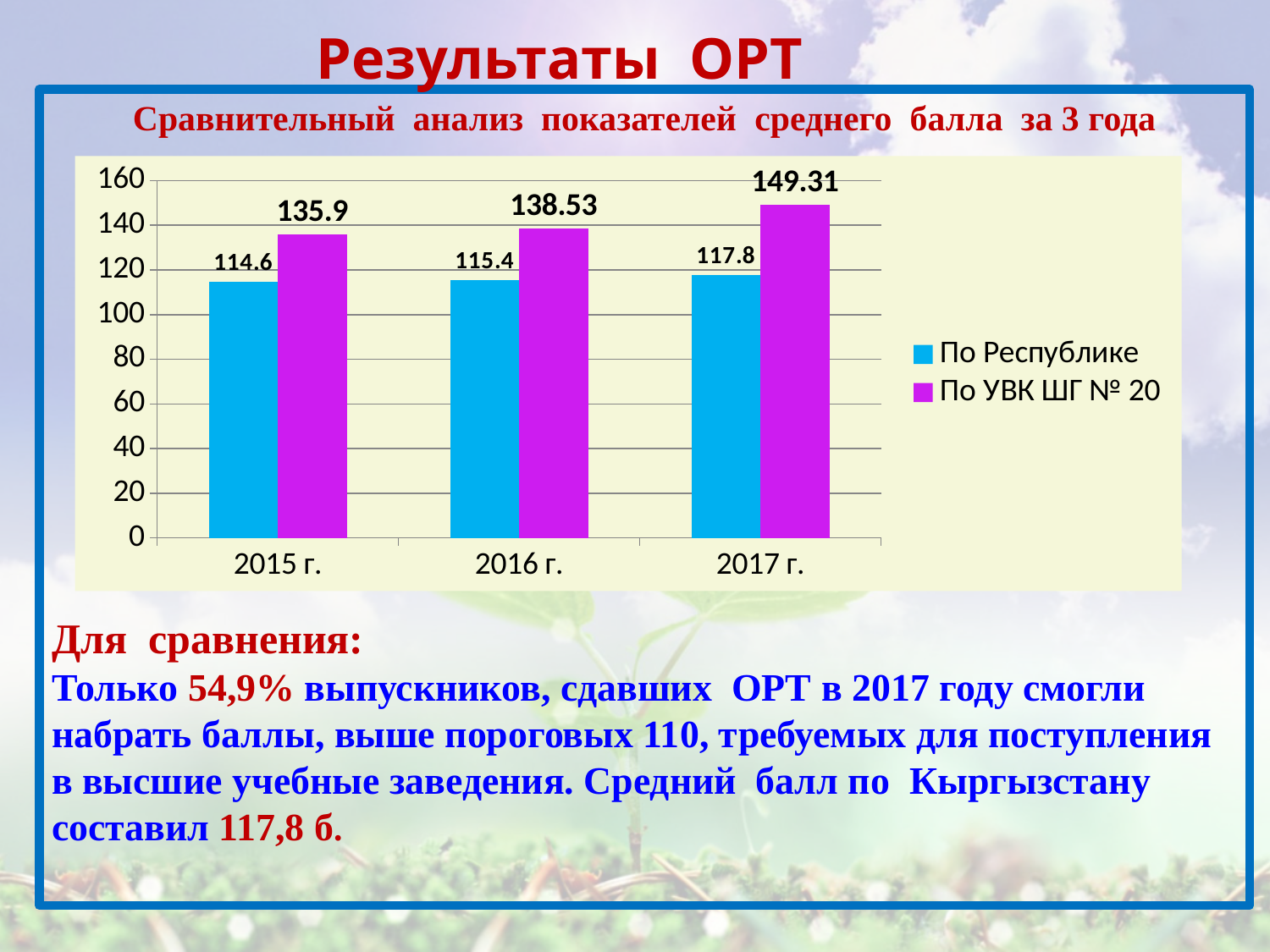
What is the difference between По УВК ШГ № 20 and По Республике in 2015 г.? 21.3 What is the value for По УВК ШГ № 20 in 2017 г.? 149.31 What is the value for По Республике in 2015 г.? 114.6 In which year is the value for По Республике the lowest? 2015 г. Do the values for По УВК ШГ № 20 rise or fall from 2015 г. to 2017 г.? rise How many years are shown on the x axis? 3 What is the value for По Республике in 2017 г.? 117.8 What is the difference between По УВК ШГ № 20 and По Республике in 2017 г.? 31.51 How many series does the legend list? 2 Which is larger in 2016 г.: По Республике or По УВК ШГ № 20? По УВК ШГ № 20 What is the value for По УВК ШГ № 20 in 2016 г.? 138.53 In which year is the value for По УВК ШГ № 20 the highest? 2017 г.